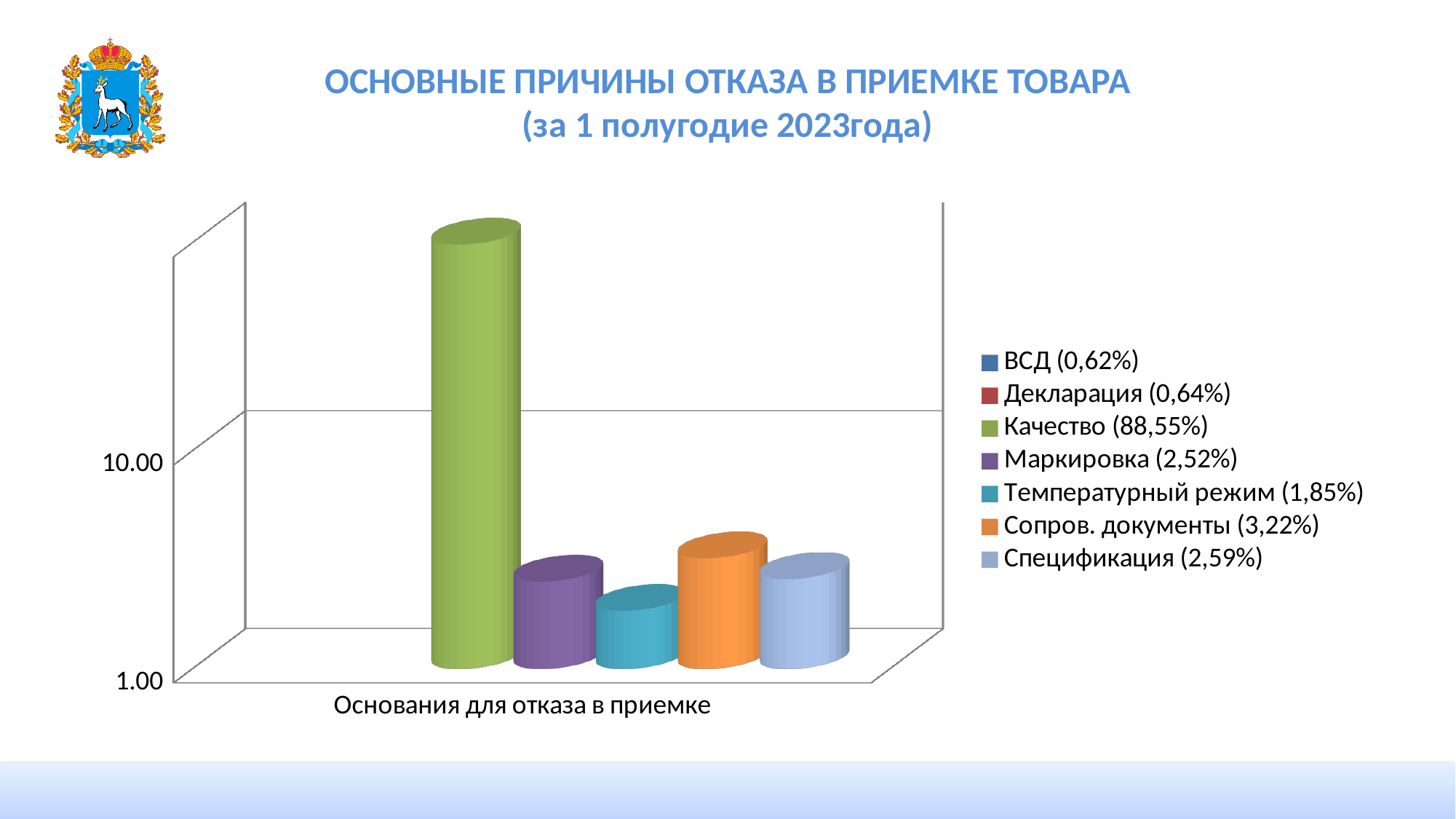
What percentage is shown for Сопров. документы? 3,22% What kind of chart is shown on the slide? bar chart How many series does the legend list? 7 Is the value for Температурный режим greater or less than 10.00 on the axis? less Which is larger, the percentage for Маркировка or for Спецификация? Спецификация What percentage is shown for Качество in the legend? 88,55% What is the label shown under the x axis of the chart? Основания для отказа в приемке Which reason for refusal has the highest percentage? Качество What percentage is shown for Температурный режим? 1,85% Is the value for Качество greater or less than 10.00 on the axis? greater Which reason for refusal has the lowest percentage according to the legend? ВСД What is the difference between the percentages for Сопров. документы and Спецификация? 0,63%